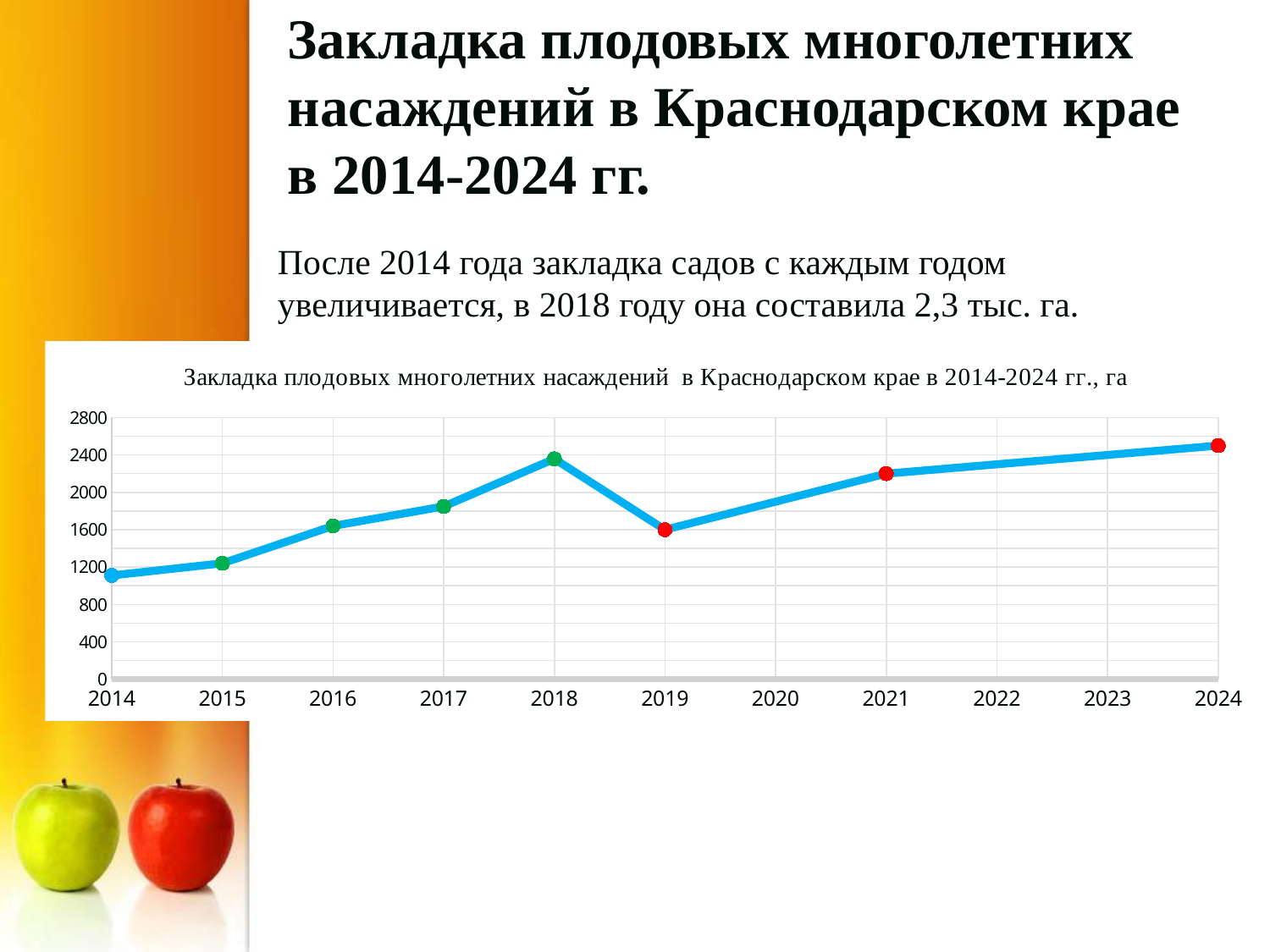
What kind of chart is shown on the slide? line chart Which year has the lowest value on the chart? 2014 Which year has the larger value, 2017 or 2021? 2021 Is the value for 2014 greater or less than 1600? less Is the value for 2017 greater or less than 1600? greater Is the value for 2024 greater or less than 2400? greater Do the values rise or fall from 2014 to 2018? rise Which year has the larger value, 2018 or 2019? 2018 Which year has the highest value on the chart? 2024 How many data points are marked on the line? 8